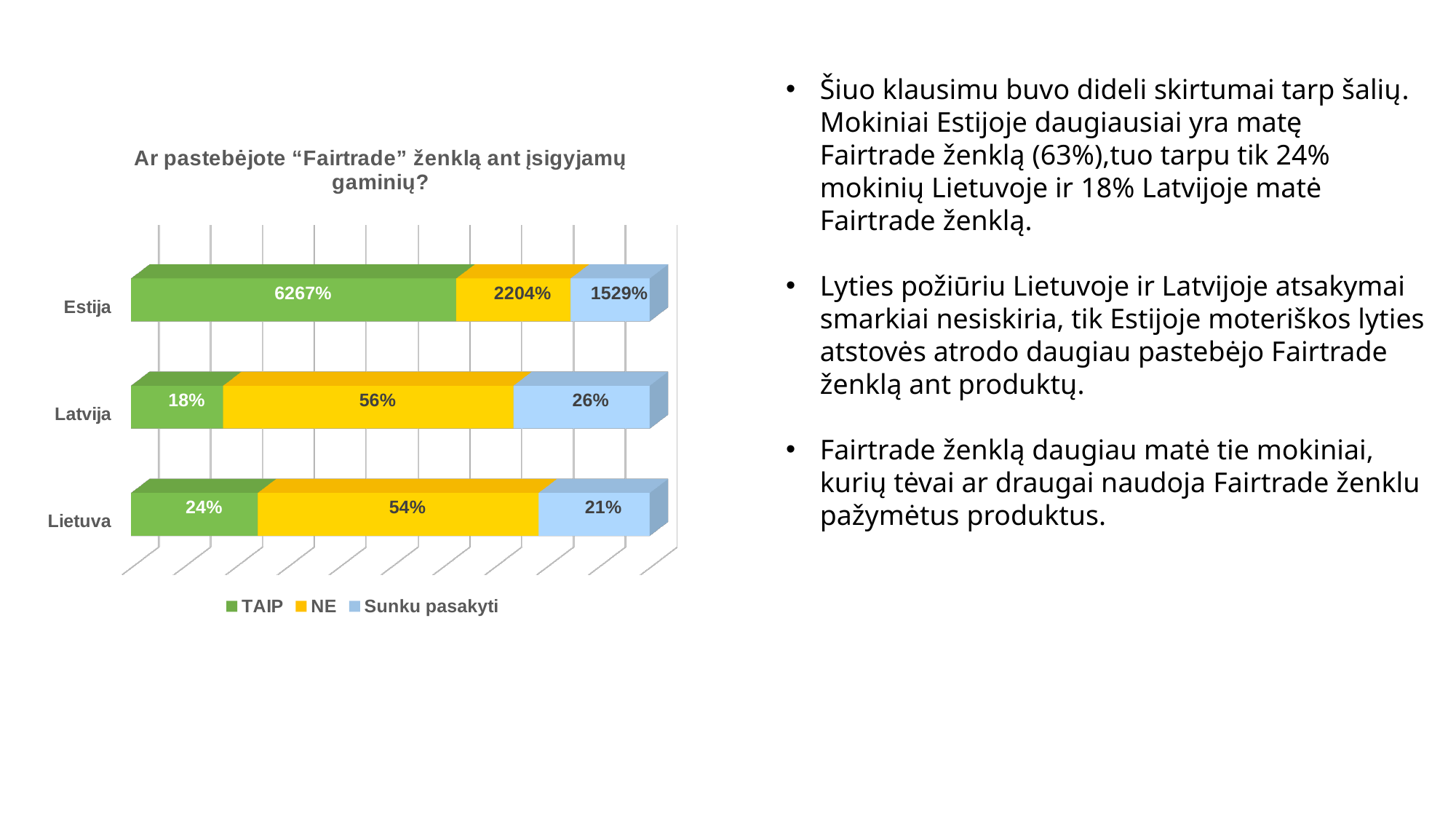
Which has the larger NE value, Latvija or Lietuva? Latvija What is the NE value for Lietuva? 54% Which country has the lowest TAIP value? Latvija Which country has the highest TAIP value? Estija What is the total of the stacked bar for Latvija? 100% How many countries (categories) are shown in the chart? 3 What is the difference between the TAIP value for Lietuva and the TAIP value for Latvija? 6% What is the TAIP value for Latvija? 18% What kind of chart is shown on the slide? bar chart How many series does the chart legend list? 3 What is the Sunku pasakyti value for Latvija? 26% What is the Sunku pasakyti value for Lietuva? 21%